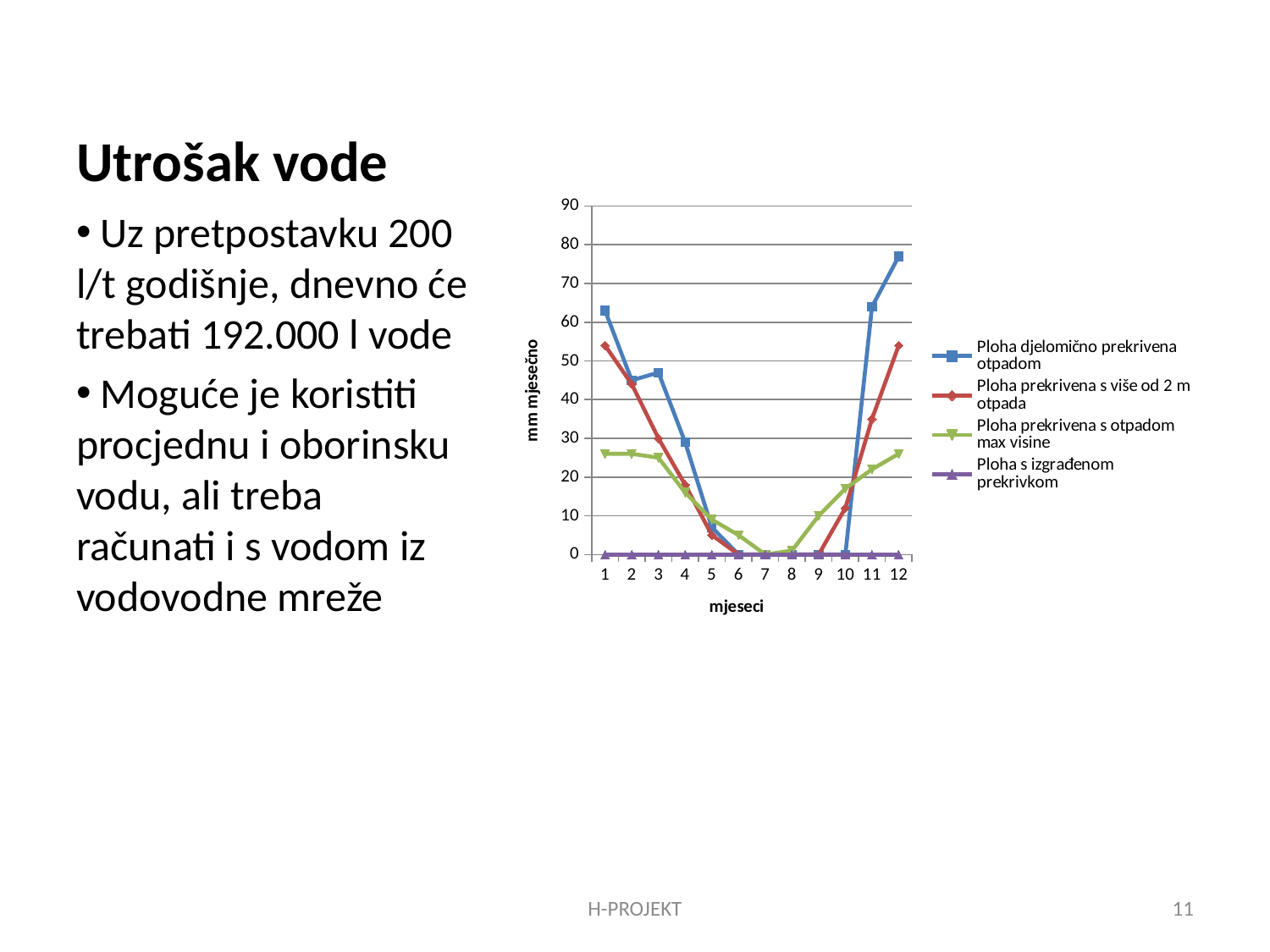
In month 11, which series has the larger value: 'Ploha djelomično prekrivena otpadom' or 'Ploha prekrivena s otpadom max visine'? Ploha djelomično prekrivena otpadom Does the series 'Ploha djelomično prekrivena otpadom' rise or fall from month 1 to month 6? fall Is the value for 'Ploha djelomično prekrivena otpadom' in month 12 greater or less than 70? greater How many series does the chart legend list? 4 What is the title of the x axis of the chart? mjeseci What kind of chart is shown on the slide? line chart What is the value of the series 'Ploha djelomično prekrivena otpadom' in month 8? 0 Is the value for 'Ploha prekrivena s otpadom max visine' in month 1 greater or less than 30? less What is the value of the series 'Ploha s izgrađenom prekrivkom' in month 7? 0 How many months are plotted along the x axis of the chart? 12 Which series has the highest value in month 12? Ploha djelomično prekrivena otpadom Is the value for 'Ploha prekrivena s više od 2 m otpada' in month 1 greater or less than 50? greater